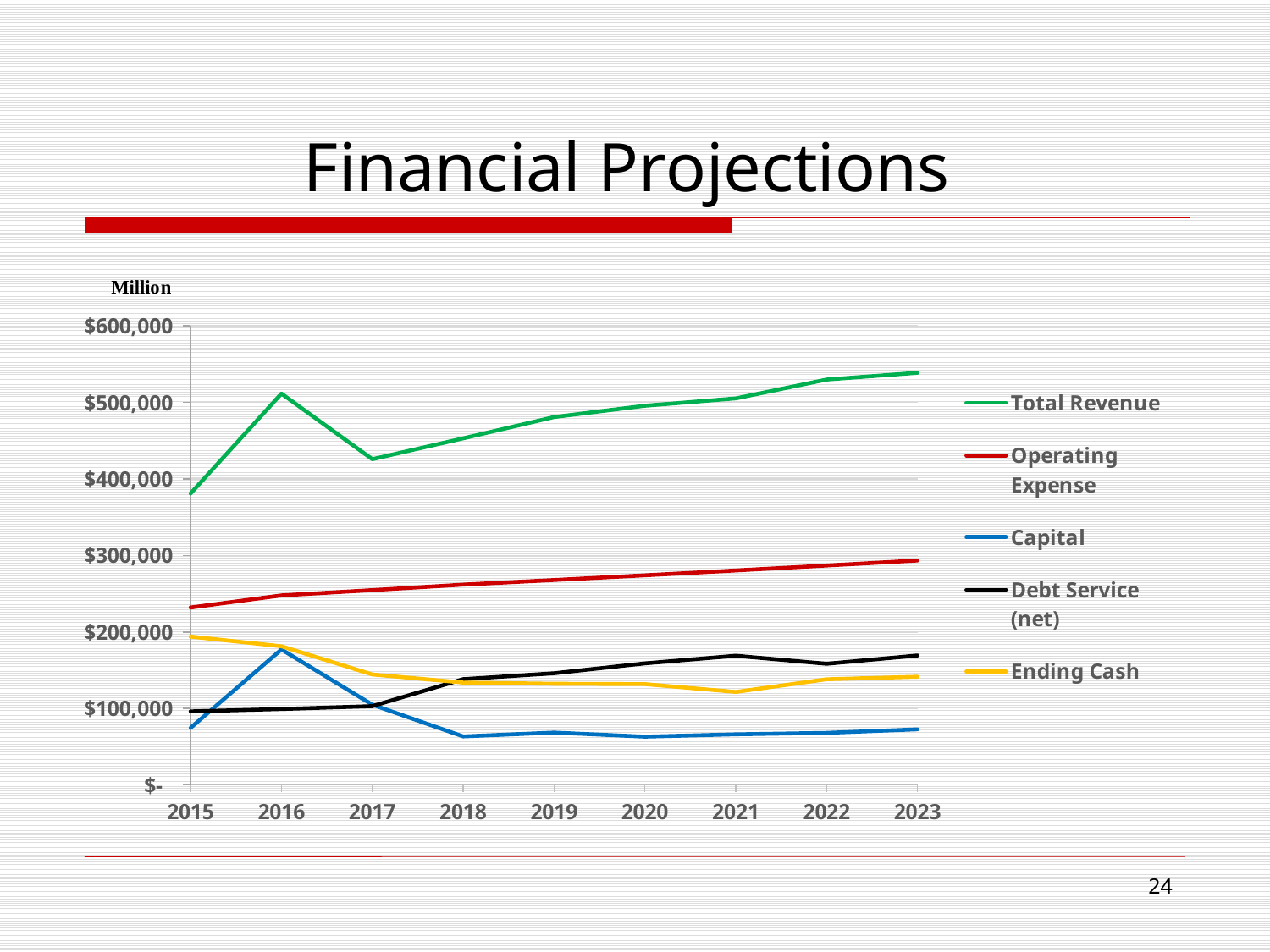
Is the value for Capital in 2018 greater or less than $100,000? less In which year does the Capital series reach its peak? 2016 Which series has the lowest value in 2023? Capital Does the Operating Expense series rise or fall from 2015 to 2023? rise What kind of chart is shown on the slide? line chart In 2021, which is larger: Debt Service (net) or Ending Cash? Debt Service (net) Is the value for Total Revenue in 2015 greater or less than $400,000? less How many years are shown along the x axis? 9 Is the value for Total Revenue in 2023 greater or less than $500,000? greater How many series does the legend list? 5 Which series has the highest values across all years? Total Revenue What colour is the Total Revenue line? green